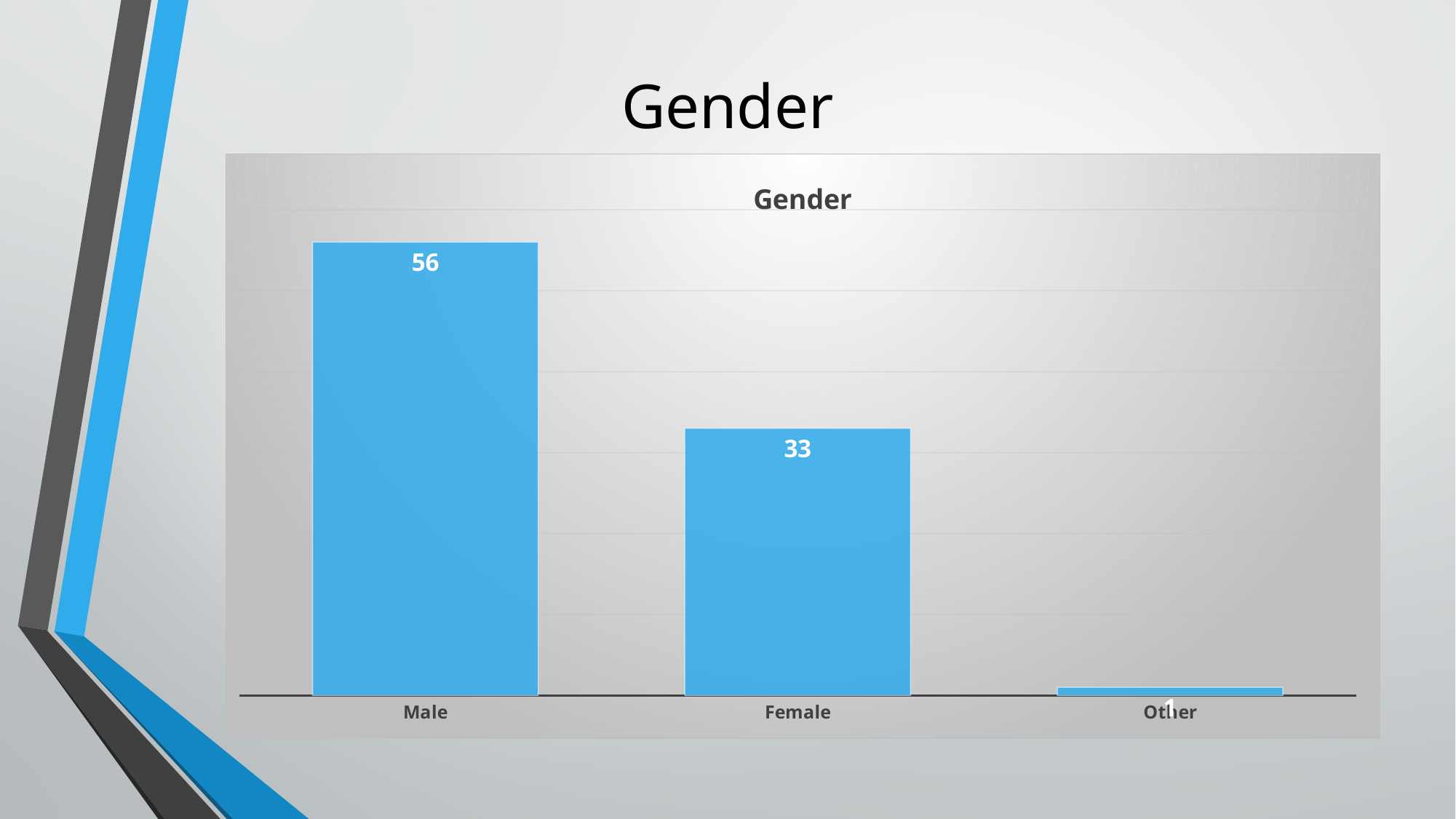
What is the value for Female? 33 Which category has the highest value? Male What is the title of the chart? Gender Do the values rise or fall from left to right along the x axis? Fall What colour are the bars in the chart? Blue What kind of chart is shown? Bar chart What is the value for Male? 56 What is the difference between the values for Male and Female? 23 Which is larger, the value for Male or the value for Female? Male How many categories are shown on the x axis? 3 Which category has the lowest value? Other Which is larger, the value for Female or the value for Other? Female